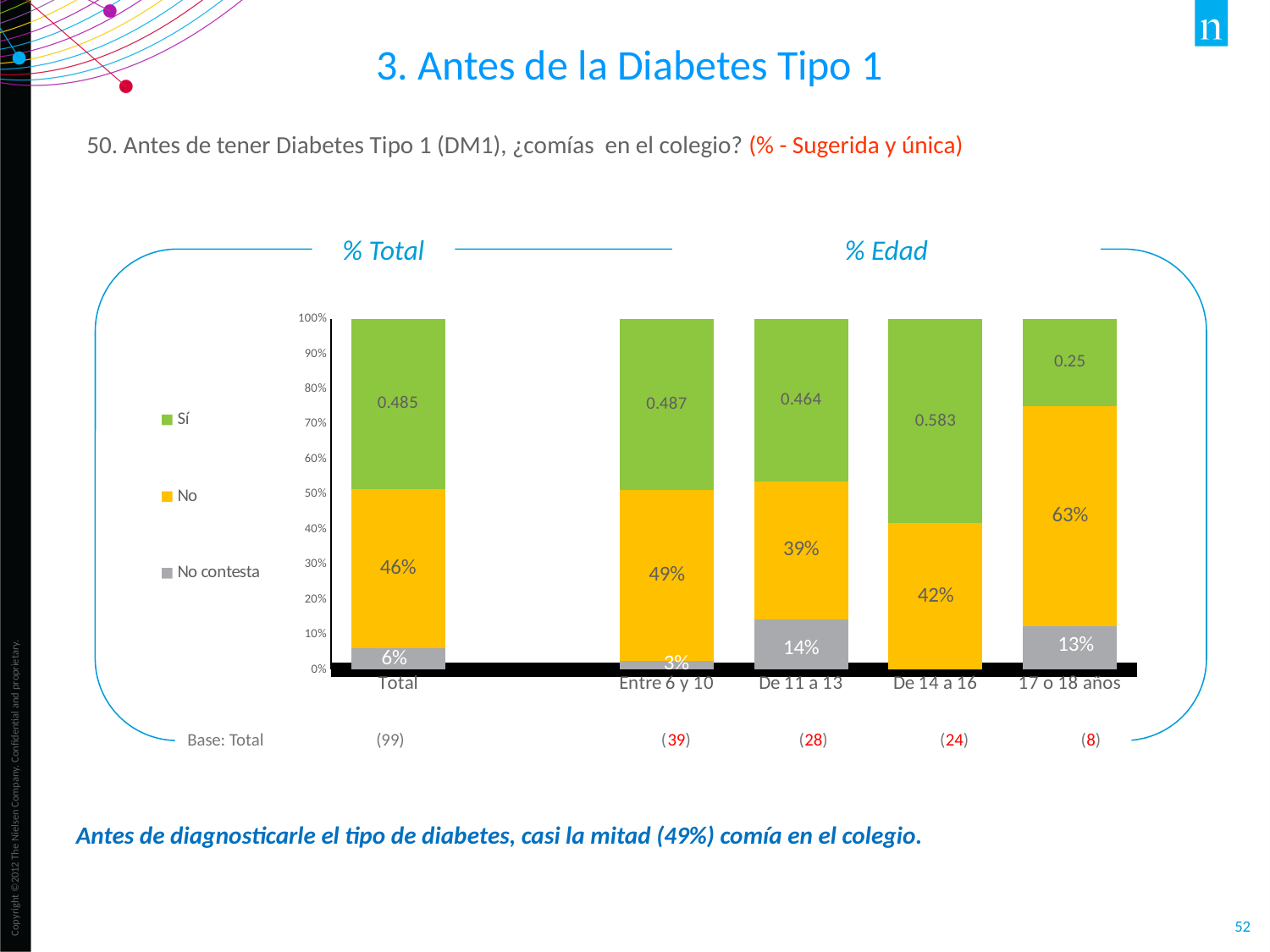
How many categories are shown on the x axis? 5 Which category has the lowest value for the 'Sí' series? 17 o 18 años What is the value of the 'No' series for the '17 o 18 años' category? 63% What is the difference between the 'No' values for 'Entre 6 y 10' and 'De 11 a 13'? 10% Which category has the highest value for the 'No' series? 17 o 18 años What kind of chart is shown on the slide? stacked bar chart What is the value of the 'Sí' series for the 'De 14 a 16' category? 0.583 Which is larger, the 'Sí' value for 'De 14 a 16' or the 'Sí' value for 'De 11 a 13'? De 14 a 16 Which legend entry is shown in green? Sí What is the value of the 'No contesta' series for the 'De 11 a 13' category? 14% What is the value of the 'No' series for the 'Total' category? 46% How many series does the legend list? 3